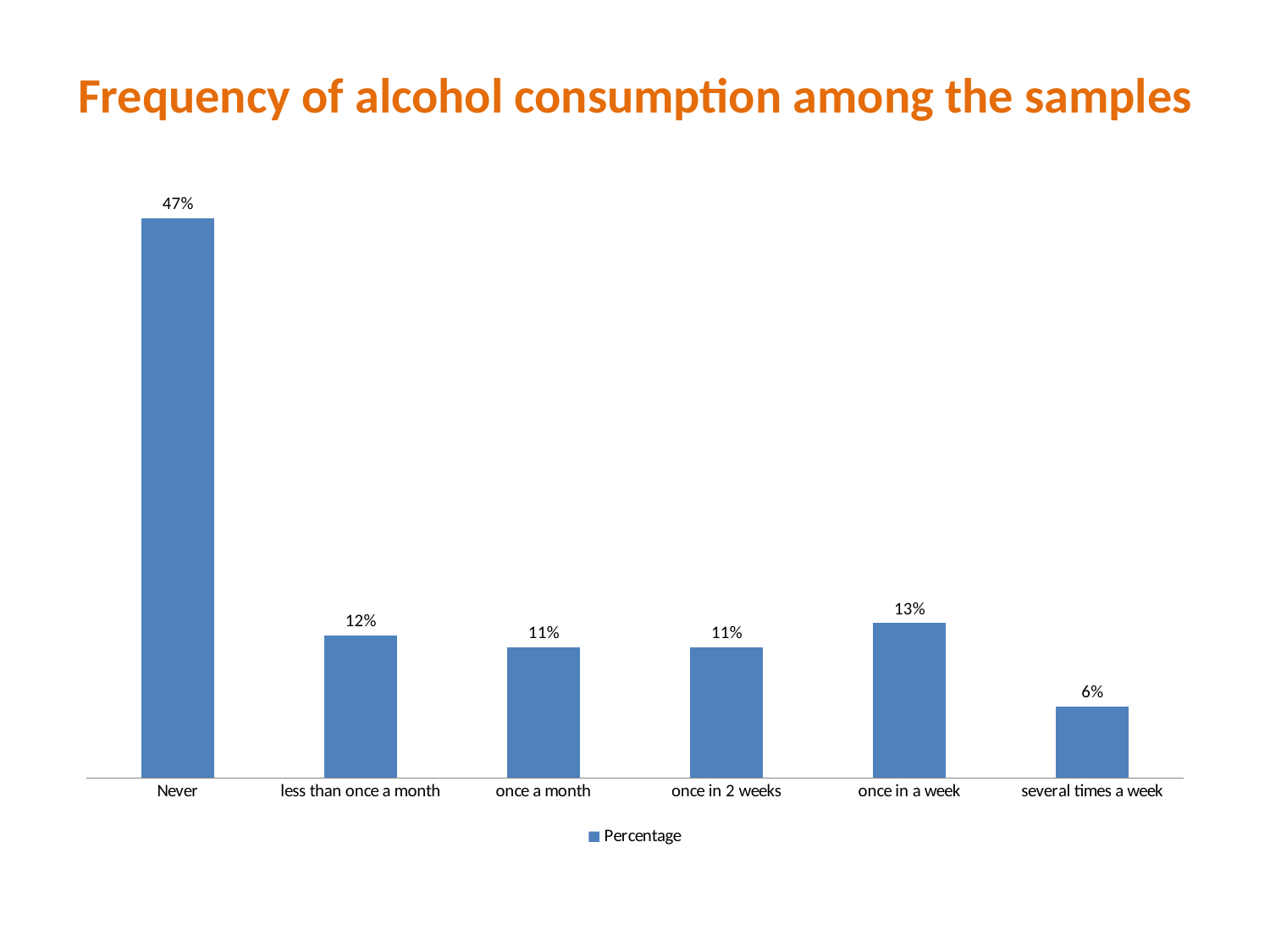
What is the percentage for "once in a week"? 13% What kind of chart is shown on the slide? bar chart Which is larger, the percentage for "once in a week" or for "once a month"? once in a week How many series does the legend list? 1 Which category has the lowest percentage? several times a week What is the percentage for "Never"? 47% What is the percentage for "several times a week"? 6% Which category has the highest percentage? Never How many categories are shown on the x axis? 6 What is the difference in percentage between "Never" and "once in a week"? 34% What is the percentage for "less than once a month"? 12% What is the difference in percentage between "less than once a month" and "several times a week"? 6%